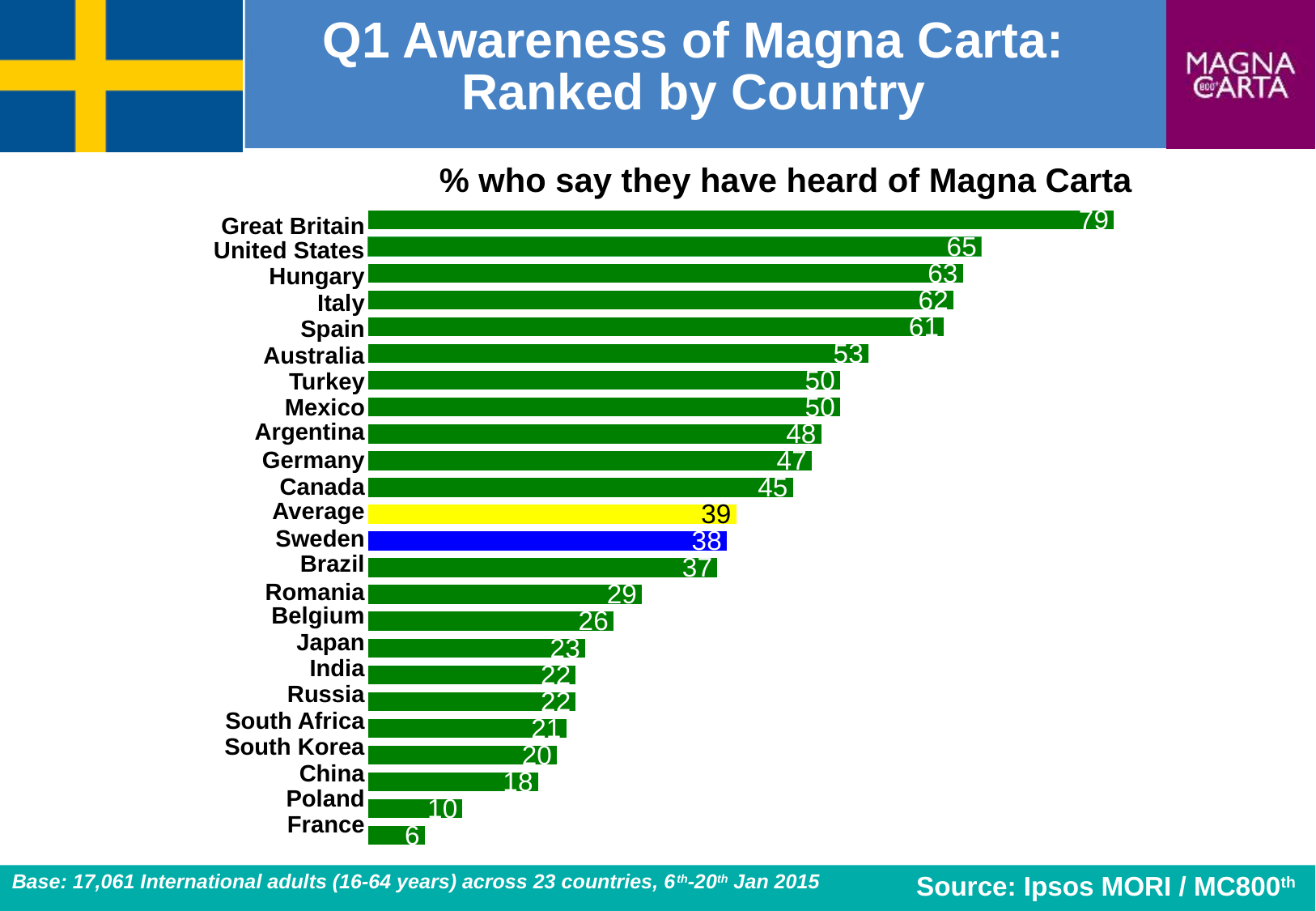
Which country has the lowest value? France Which has a larger value, Australia or Canada? Australia What is the value shown for Average? 39 What is the value for Great Britain? 79 What is the difference between the values for Great Britain and the United States? 14 What is the value for Sweden? 38 How many bars are shown in the chart? 24 What kind of chart is shown on the slide? Bar chart What is the difference between the values for Sweden and the Average? 1 Which has a larger value, Poland or China? China Which country has the highest value? Great Britain Which bar is coloured blue? Sweden